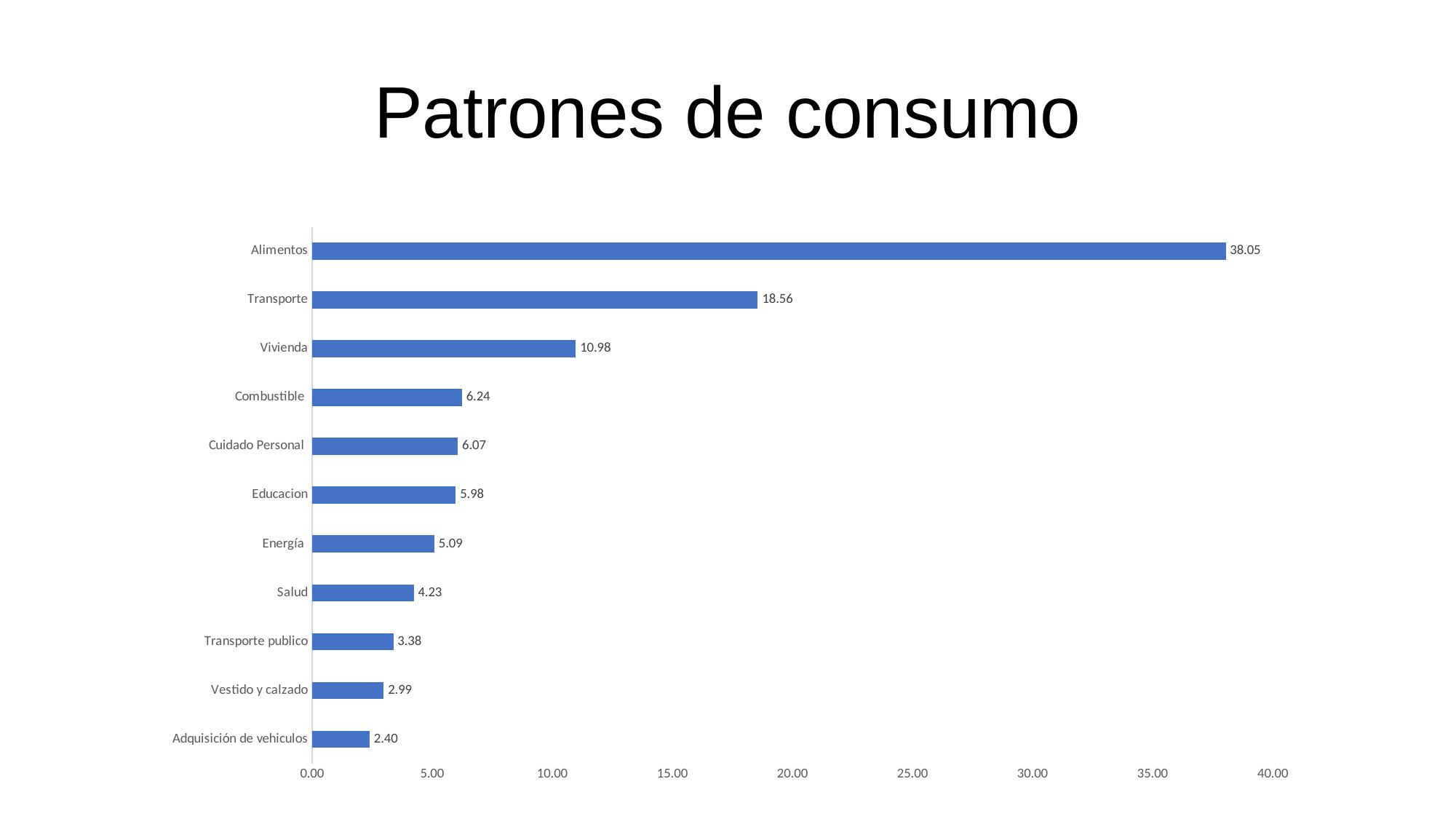
Which is larger, the value for Transporte or the value for Vivienda? Transporte What is the title of the slide? Patrones de consumo How many categories are shown in the chart? 11 What kind of chart is shown on the slide? bar chart What is the difference between the values for Alimentos and Transporte? 19.49 Which category has the highest value? Alimentos What is the difference between the values for Transporte publico and Vestido y calzado? 0.39 Which category has the lowest value? Adquisición de vehiculos What is the value for Alimentos? 38.05 Is the value for Transporte greater or less than 15.00? greater What is the value for Salud? 4.23 What is the value for Vivienda? 10.98